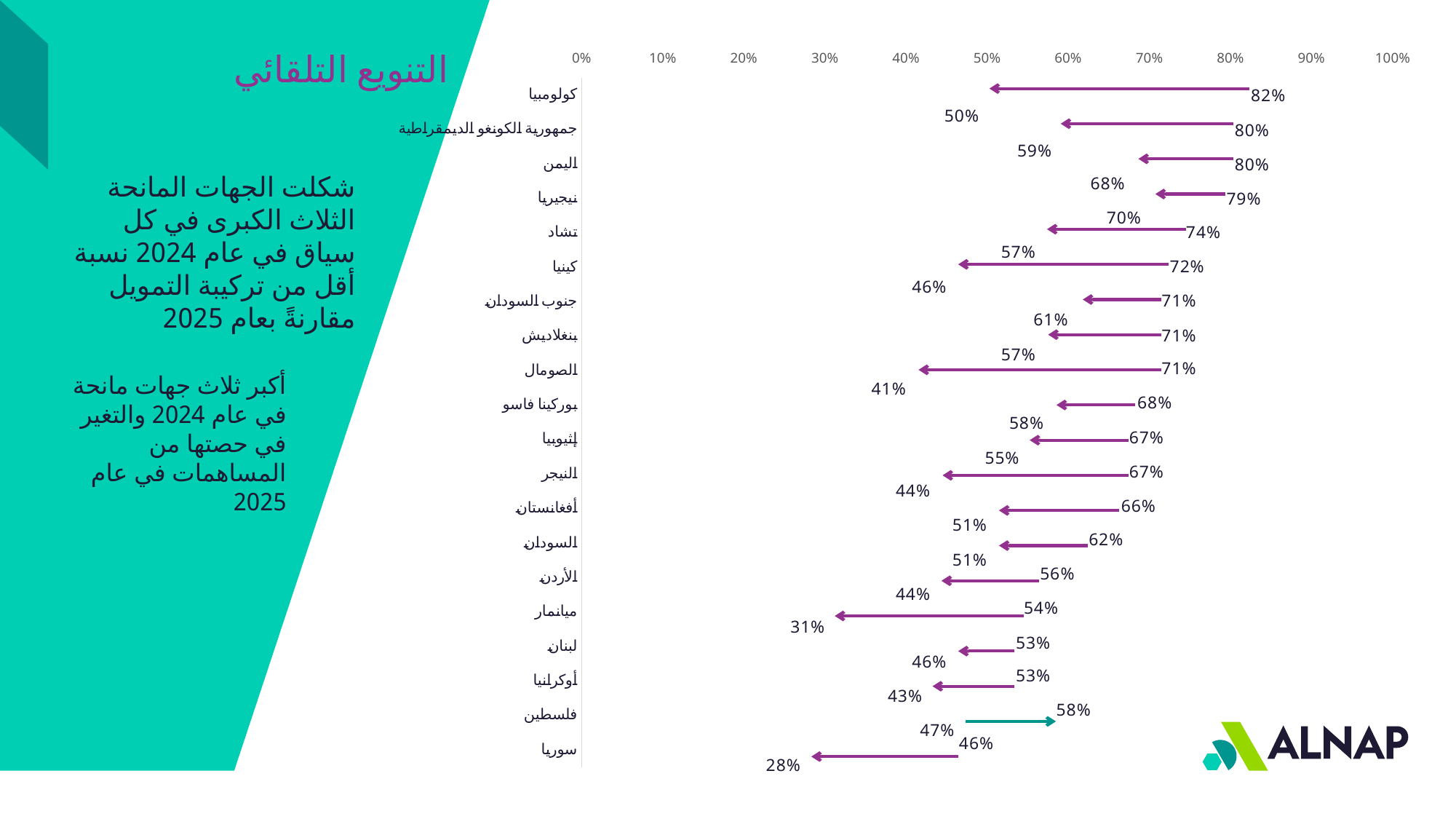
What is the 2025 value (end of the arrow) for سوريا (Syria)? 28% What is the 2024 value (start of the arrow) for كولومبيا (Colombia)? 82% What is the 2025 value (end of the arrow) for فلسطين (Palestine)? 58% What is the difference between the 2024 and 2025 values for كينيا (Kenya)? 26 percentage points Which is larger: the 2025 value for اليمن (Yemen) or the 2025 value for تشاد (Chad)? اليمن (Yemen) What is the maximum value shown on the horizontal axis? 100% What is the 2024 value (start of the arrow) for ميانمار (Myanmar)? 54% How many countries are listed on the chart? 20 What is the difference between the 2024 and 2025 values for الصومال (Somalia)? 30 percentage points Which country has the lowest 2025 value (end of the arrow)? سوريا (Syria) Which country has the highest 2024 value (start of the arrow)? كولومبيا (Colombia) Which country is the only one whose arrow points to the right, showing an increase from 2024 to 2025? فلسطين (Palestine)